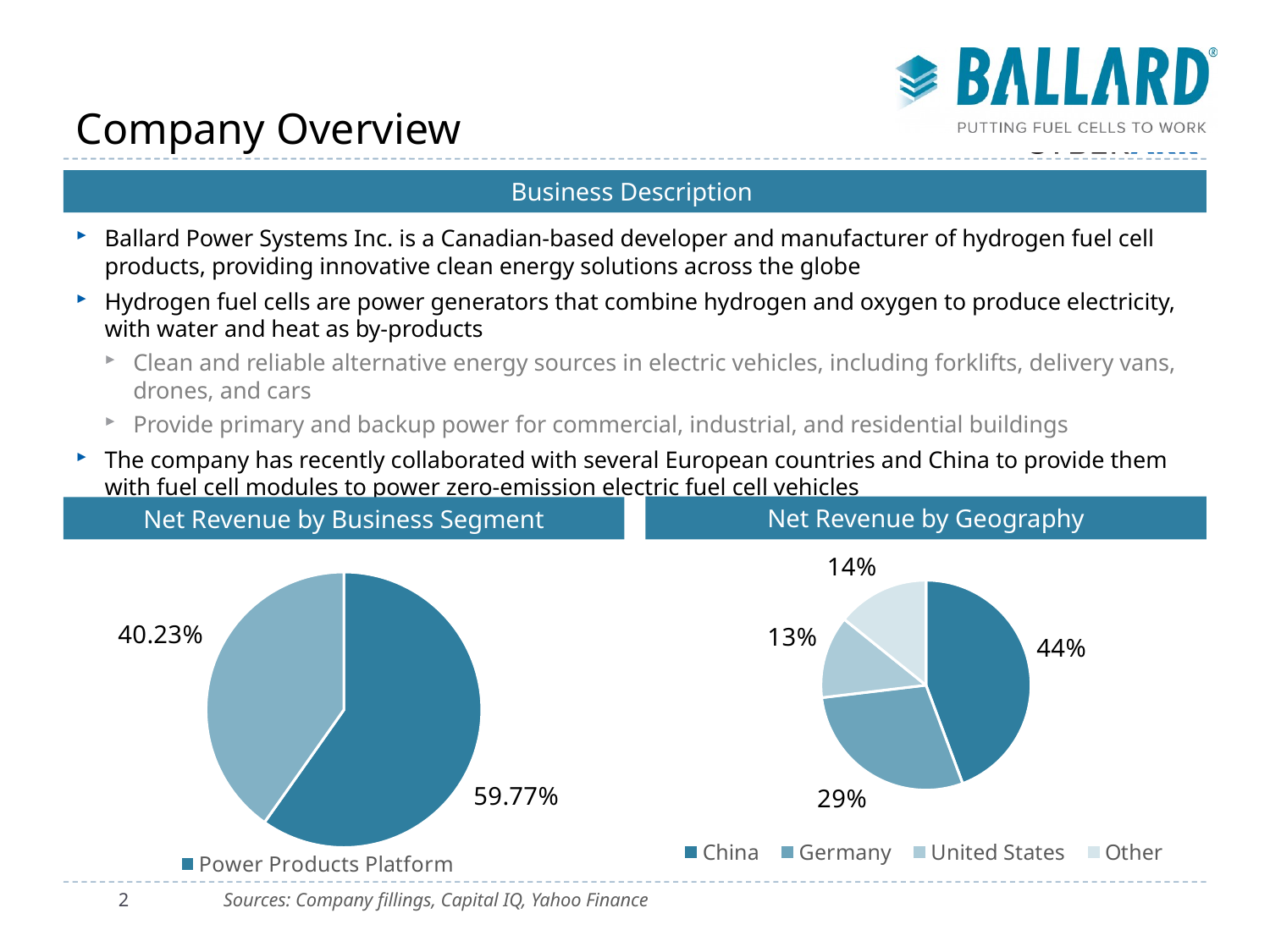
In the 'Net Revenue by Geography' chart, what share is shown for Other? 14% How many entries does the legend of the 'Net Revenue by Geography' chart list? 4 In the 'Net Revenue by Geography' chart, which geography has the smallest share? United States In the 'Net Revenue by Geography' chart, what share is shown for Germany? 29% How many slices does the 'Net Revenue by Business Segment' pie chart have? 2 What kind of chart is the 'Net Revenue by Business Segment' chart? pie chart In the 'Net Revenue by Geography' chart, what share is shown for United States? 13% In the 'Net Revenue by Geography' chart, which geography has the largest share? China In the 'Net Revenue by Geography' chart, which is larger, the share for Germany or the share for Other? Germany In the 'Net Revenue by Geography' chart, what is the difference between the shares for China and Germany? 15% In the 'Net Revenue by Business Segment' chart, what share is labelled for Power Products Platform? 59.77% In the 'Net Revenue by Geography' chart, what share is shown for China? 44%